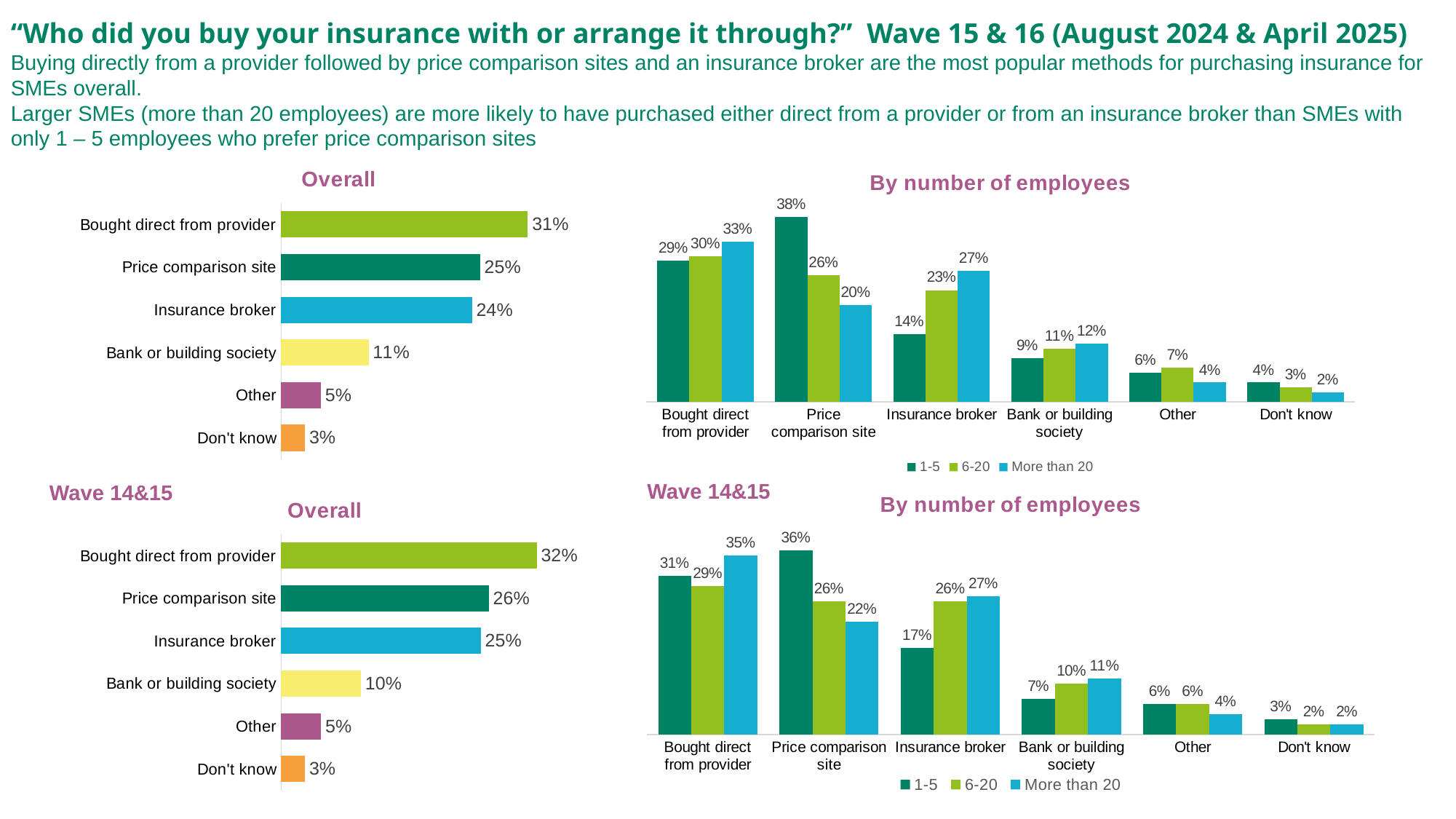
In the top-right 'By number of employees' chart, how many series does the legend list? 3 What kind of chart is the top-left 'Overall' chart? Bar chart In the top-left 'Overall' chart, what is the difference between 'Price comparison site' and 'Insurance broker'? 1% In the top-right 'By number of employees' chart, which is larger for 'Insurance broker': the 1-5 value or the 'More than 20' value? More than 20 In the bottom-left 'Wave 14&15 Overall' chart, how many categories are shown? 6 In the top-right 'By number of employees' chart, which category has the highest value for the 6-20 series? Bought direct from provider In the bottom-right 'Wave 14&15 By number of employees' chart, what is the difference between the 1-5 and 6-20 values for 'Insurance broker'? 9% In the top-left 'Overall' chart, which category has the lowest value? Don't know In the bottom-left 'Wave 14&15 Overall' chart, what is the value for 'Bank or building society'? 10% In the bottom-right 'Wave 14&15 By number of employees' chart, what is the value for 'Bought direct from provider' for the 'More than 20' series? 35% In the top-left 'Overall' chart, what is the value for 'Bought direct from provider'? 31% In the top-right 'By number of employees' chart, what is the value for 'Price comparison site' for the 1-5 series? 38%